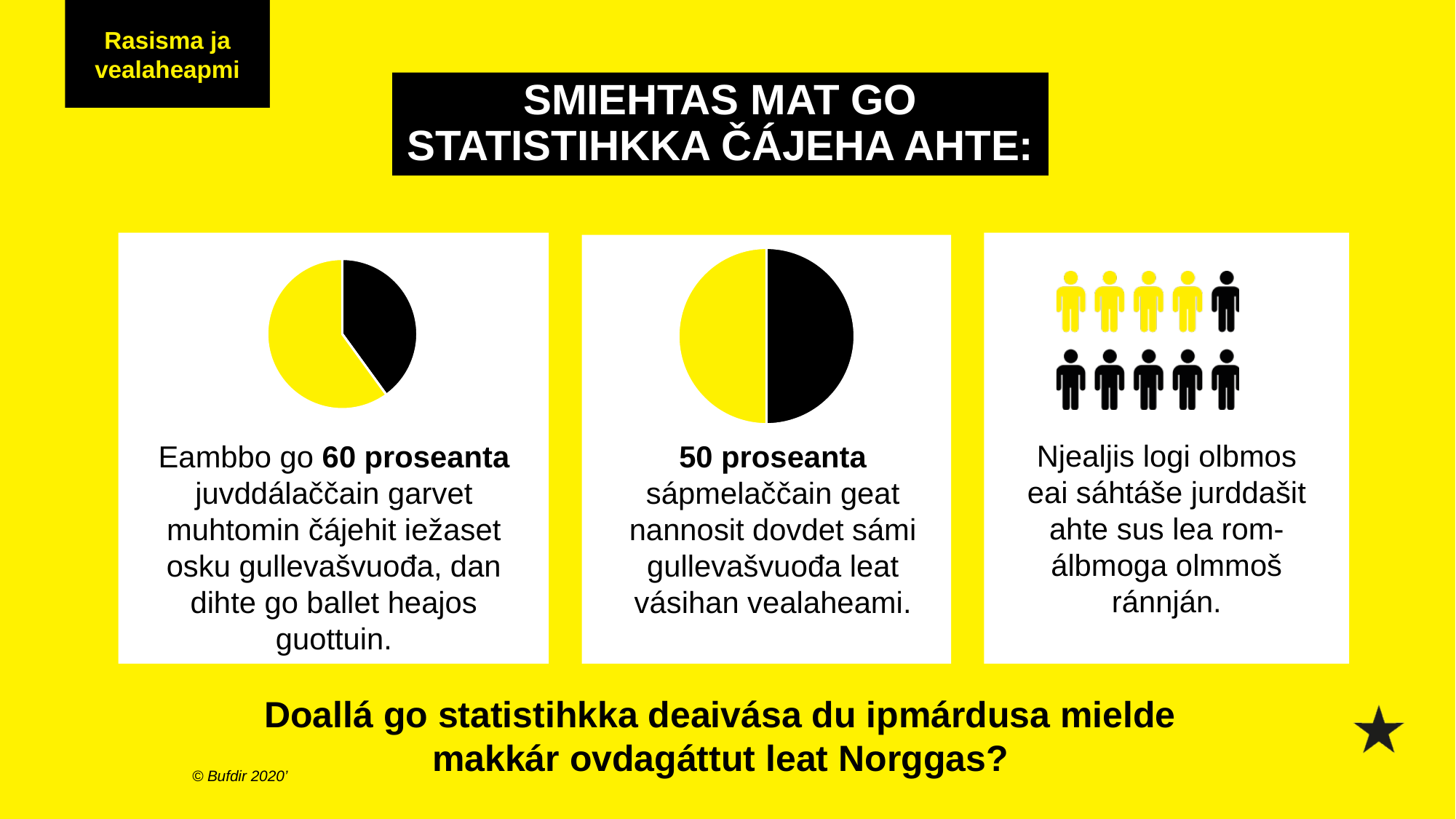
In the left pie chart, which slice is larger, the yellow one or the black one? yellow In the right-hand pictogram, how many person icons are shown in total? 10 What two colours are used for the slices in the pie charts? yellow and black In the right-hand pictogram, how many person icons are black? 6 What kind of chart is the middle chart on the slide? pie chart According to the text under the middle pie chart, what share does the yellow slice represent? 50 proseanta What kind of chart is the left chart on the slide? pie chart According to the text under the left pie chart, what share does the yellow slice represent? 60 proseanta In the right-hand pictogram, are there more yellow icons or more black icons? black How many slices does the middle pie chart have? 2